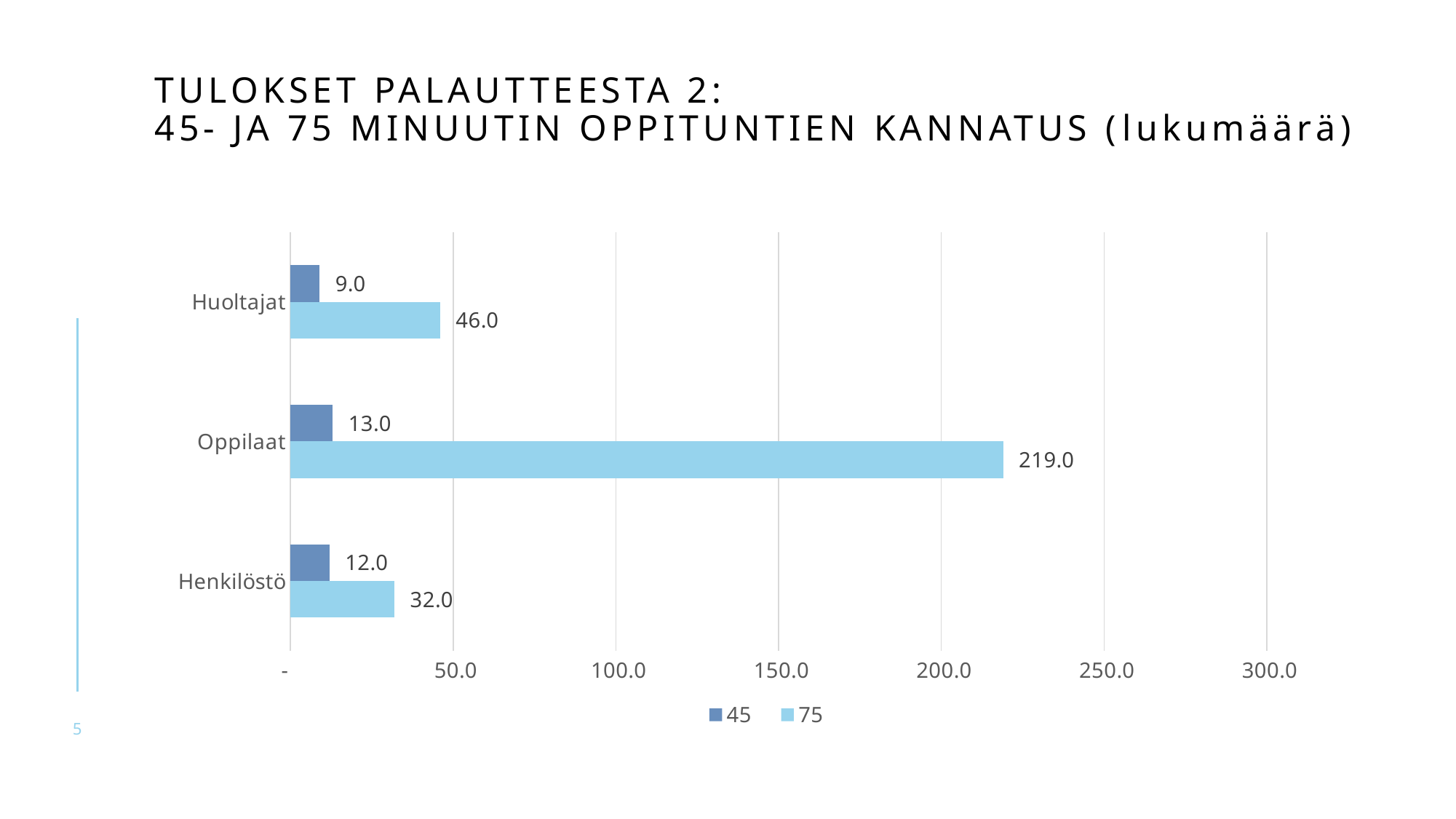
Which category has the lowest value in the 45 series? Huoltajat Which is larger: the 45 value for Henkilöstö or the 45 value for Huoltajat? Henkilöstö What kind of chart is shown on the slide? Bar chart What is the value for the 75 series for Henkilöstö? 32.0 What is the difference between the 75 values for Huoltajat and Henkilöstö? 14.0 How many categories are shown on the chart? 3 Which category has the highest value in the 75 series? Oppilaat How many series does the legend list? 2 What is the value for the 45 series for Huoltajat? 9.0 What is the value for the 75 series for Oppilaat? 219.0 What is the value for the 45 series for Oppilaat? 13.0 What is the difference between the 75 and 45 values for Oppilaat? 206.0